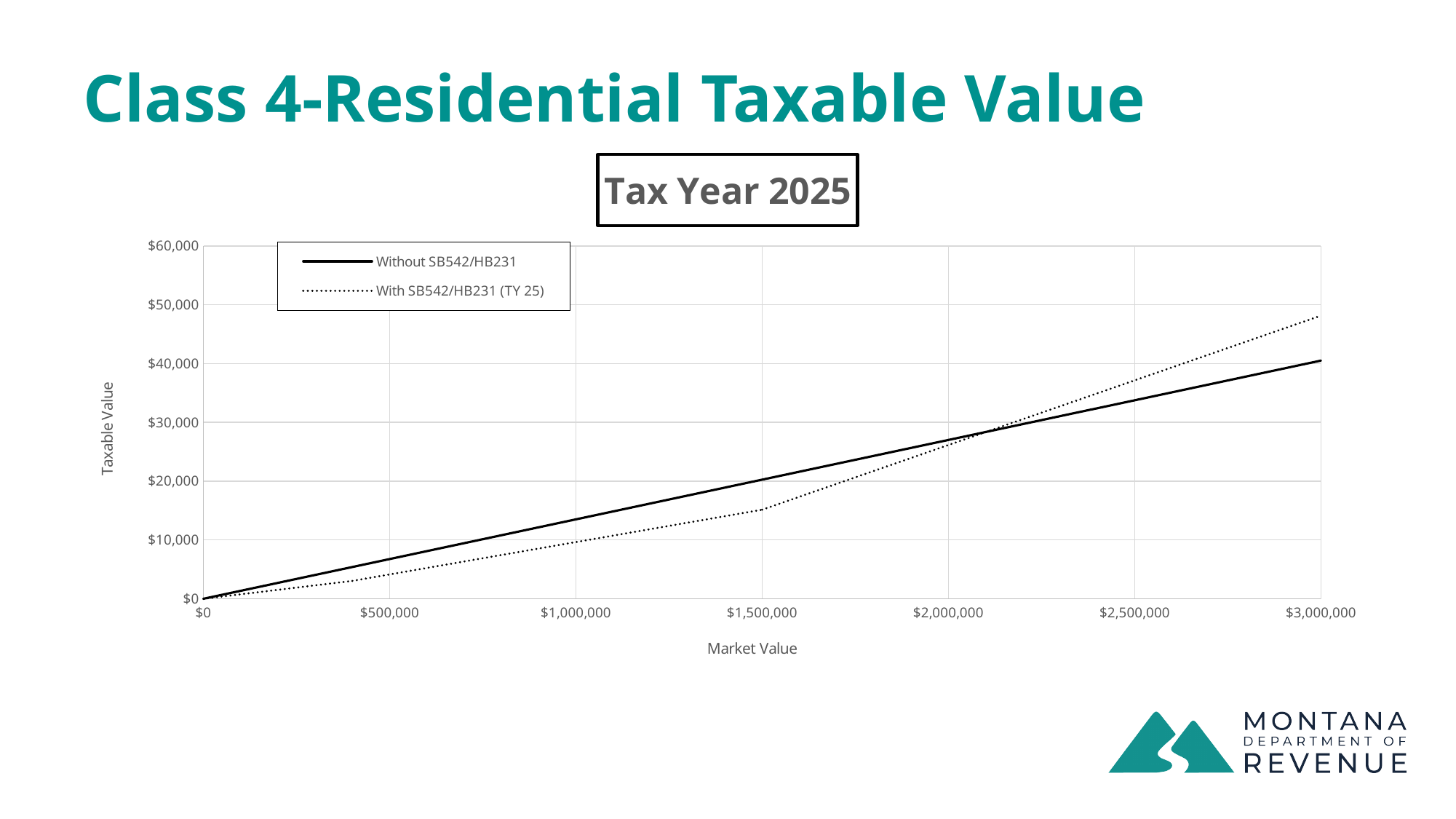
At a market value of $3,000,000, which series has the higher taxable value: 'Without SB542/HB231' or 'With SB542/HB231 (TY 25)'? With SB542/HB231 (TY 25) At a market value of $1,000,000, which series has the higher taxable value: 'Without SB542/HB231' or 'With SB542/HB231 (TY 25)'? Without SB542/HB231 Does the 'With SB542/HB231 (TY 25)' line rise or fall as market value increases? Rises Is the taxable value for 'With SB542/HB231 (TY 25)' at a market value of $1,500,000 greater or less than $20,000? less Is the taxable value for 'Without SB542/HB231' at a market value of $2,000,000 greater or less than $30,000? less At a market value of $500,000, which series has the higher taxable value: 'Without SB542/HB231' or 'With SB542/HB231 (TY 25)'? Without SB542/HB231 How many series does the chart's legend list? 2 Does the 'Without SB542/HB231' line rise or fall as market value increases? Rises Is the taxable value for 'With SB542/HB231 (TY 25)' at a market value of $3,000,000 greater or less than $40,000? greater What is the label of the chart's x axis? Market Value What is the title shown above the chart? Tax Year 2025 What kind of chart is shown on the slide? Line chart